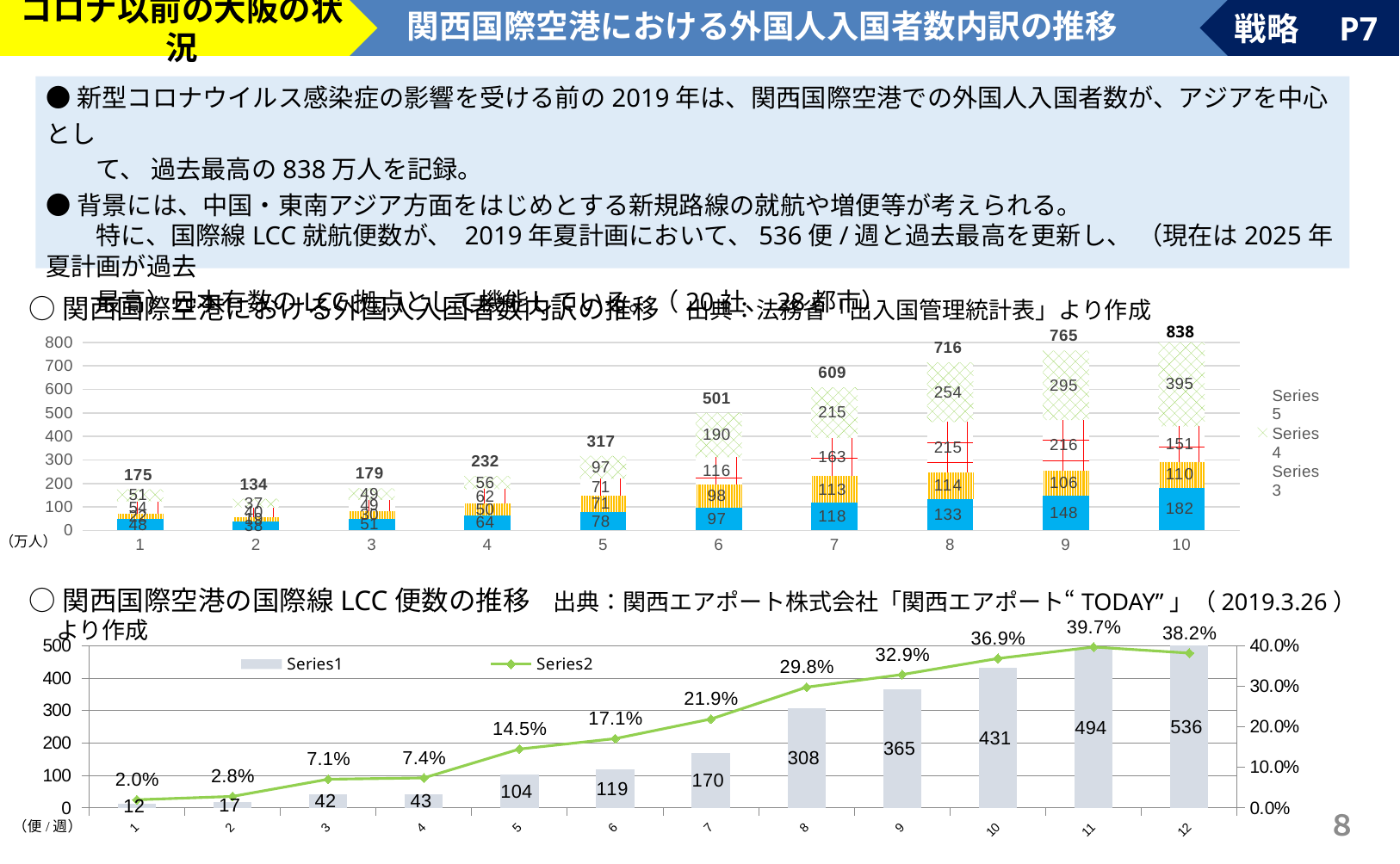
In the top chart, what is the value of Series 4 (the green cross-hatched segment) for category 9? 295 In the top chart (関西国際空港における外国人入国者数内訳の推移), what is the total shown above the stacked bar for category 10? 838 In the bottom chart, how many series does the legend list? 2 In the top chart, how many categories are shown on the x axis? 10 In the top chart, what is the value of Series 3 (the blue segment) for category 10? 182 In the bottom chart, which category has the highest Series1 bar value? 12 In the top chart, is the total for category 7 greater or less than 600? greater In the bottom chart (関西国際空港の国際線LCC便数の推移), what is the Series1 bar value for category 12? 536 In the bottom chart, what is the Series2 percentage for category 11? 39.7% In the top chart, which category has the lowest total? 2 In the top chart, what is the difference between the totals for category 10 and category 9? 73 In the bottom chart, which is larger: the Series2 value for category 11 or for category 12? category 11